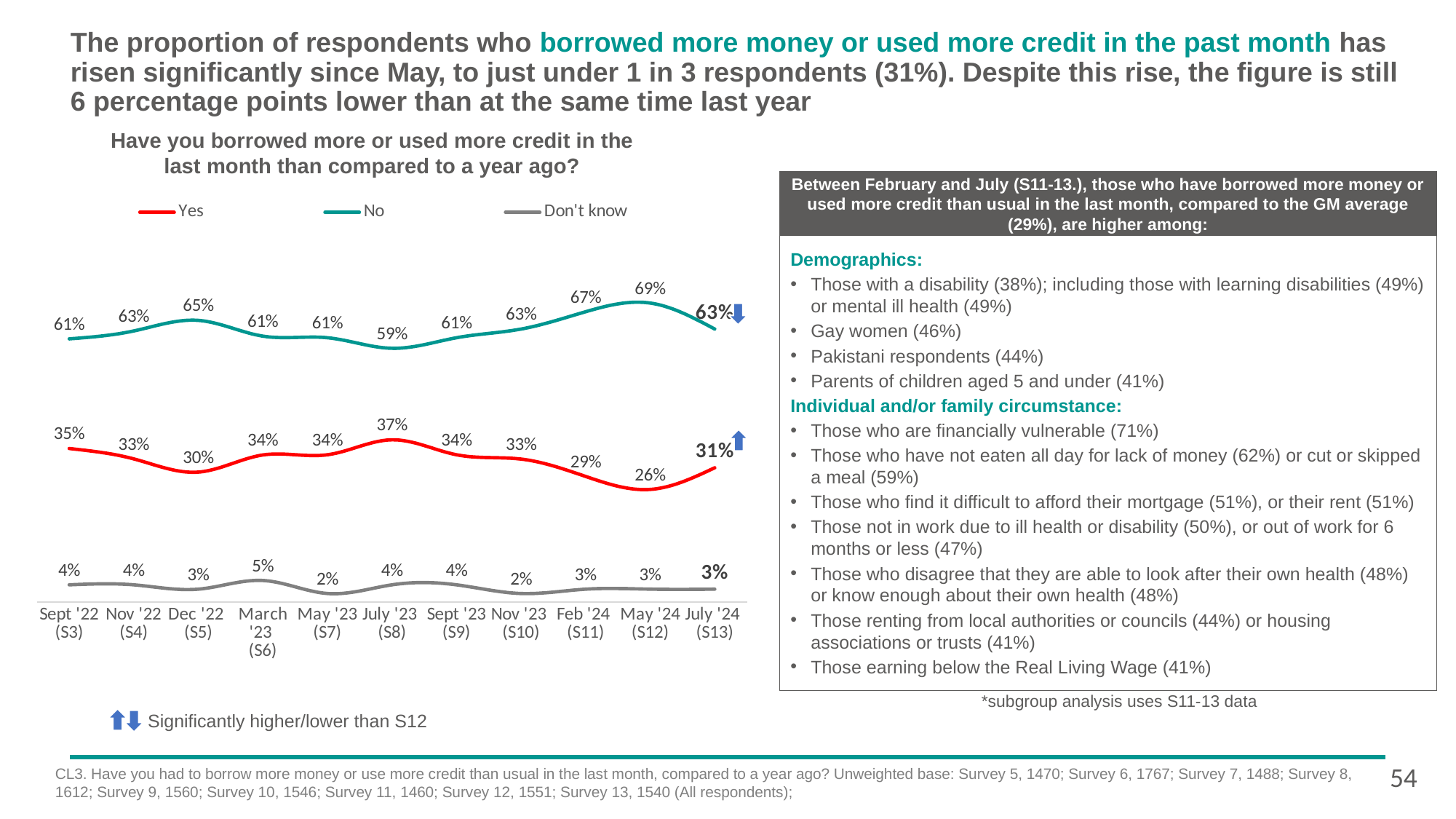
What is the value for 'No' in May '24 (S12)? 69% Which is larger: the 'No' value in Feb '24 (S11) or in Nov '23 (S10)? Feb '24 (S11) How many survey points are plotted along the x axis? 11 What is the value for 'Don't know' in March '23 (S6)? 5% At which survey point is the 'Yes' series highest? July '23 (S8) What is the value for 'Yes' in July '24 (S13)? 31% What type of chart is shown on the slide? Line chart At which survey point is the 'No' series lowest? July '23 (S8) Which series is shown in red in the chart? Yes How many series does the chart legend list? 3 What is the difference between the 'Yes' value in July '24 (S13) and May '24 (S12)? 5 percentage points At which survey point is the 'Yes' series lowest? May '24 (S12)